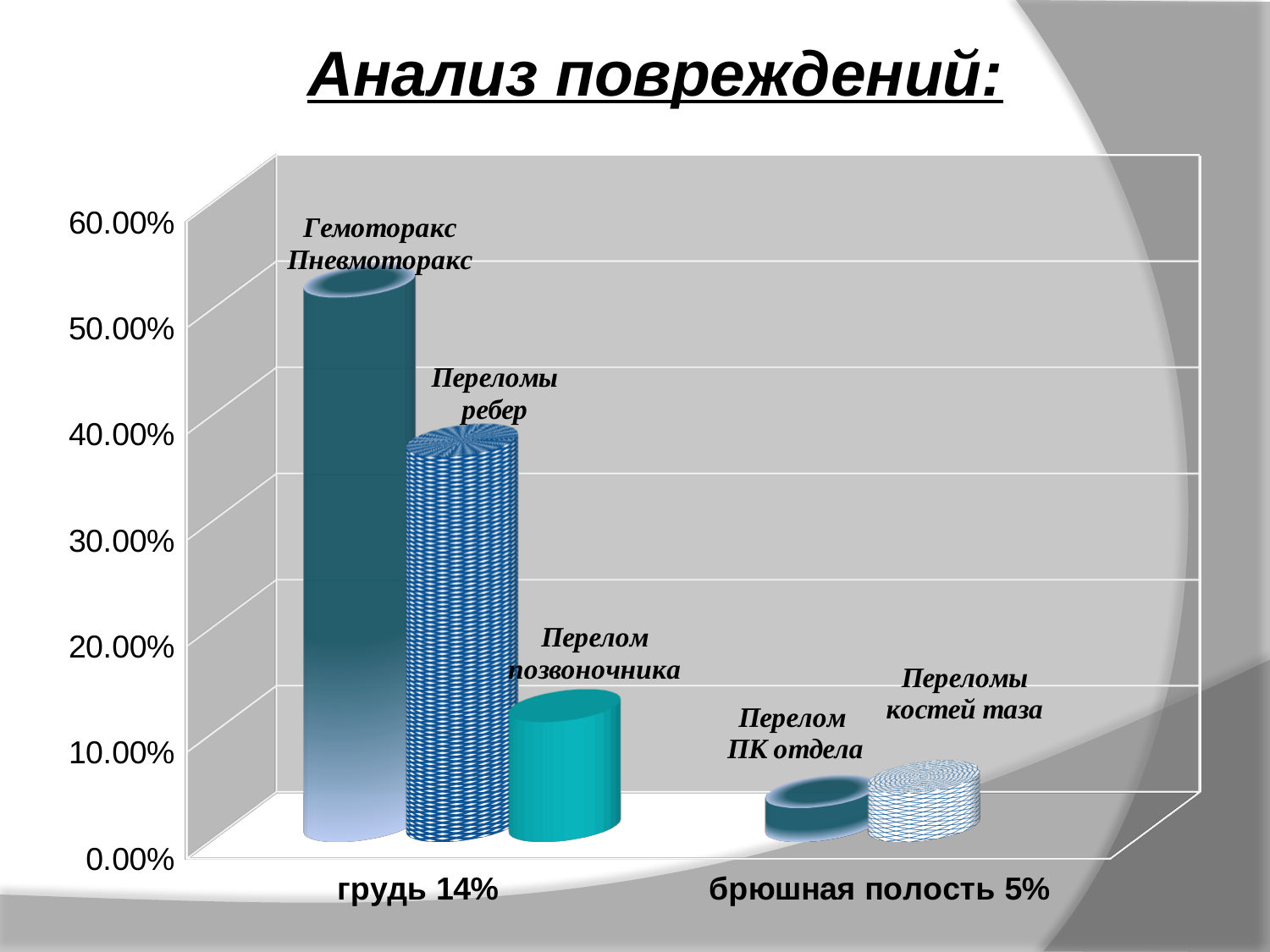
How many category groups are labelled on the x axis of the chart? 2 Is the value for Перелом позвоночника greater or less than 20.00%? less Is the value for Гемоторакс Пневмоторакс greater or less than 40.00%? greater Which injury has the highest bar in the chart? Гемоторакс Пневмоторакс What is the title of the chart on the slide? Анализ повреждений: Which is larger, the bar for Переломы ребер or the bar for Перелом позвоночника? Переломы ребер How many bars are plotted in the chart? 5 Is the value for Переломы ребер greater or less than 30.00%? greater What is the label of the second category group on the x axis? брюшная полость 5% Which injury has the lowest bar in the chart? Перелом ПК отдела What kind of chart is shown on the slide? bar chart